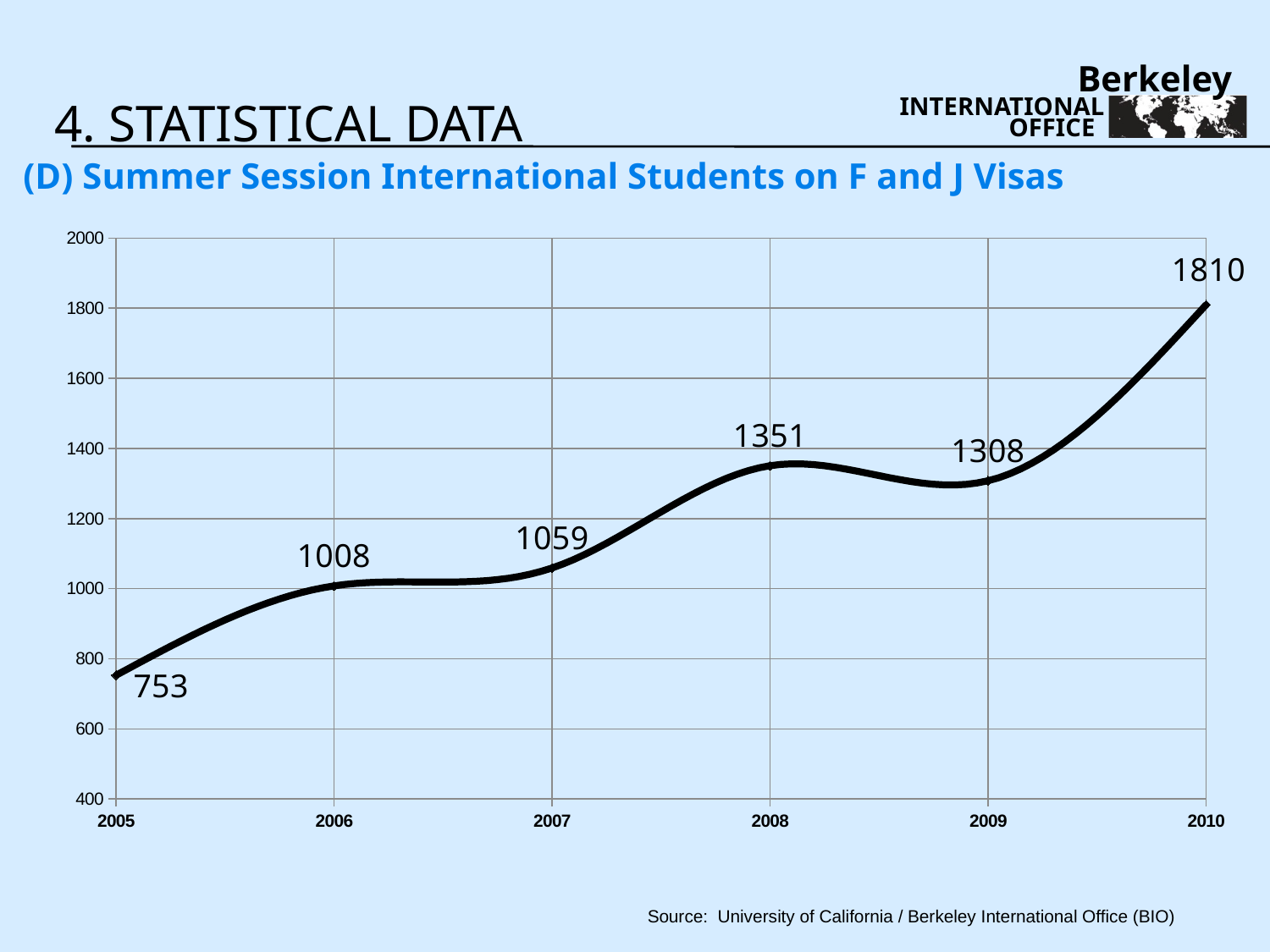
Which year has the lowest value? 2005 What is the difference between the values for 2010 and 2009? 502 Does the value rise or fall from 2008 to 2009? fall What is the difference between the values for 2008 and 2007? 292 What is the value for 2008? 1351 What kind of chart is shown? line chart What is the value for 2010? 1810 Which is larger, the value for 2008 or the value for 2009? 2008 Which year has the highest value? 2010 What is the value for 2005? 753 Is the value for 2006 greater or less than 1200? less How many years are plotted on the chart? 6